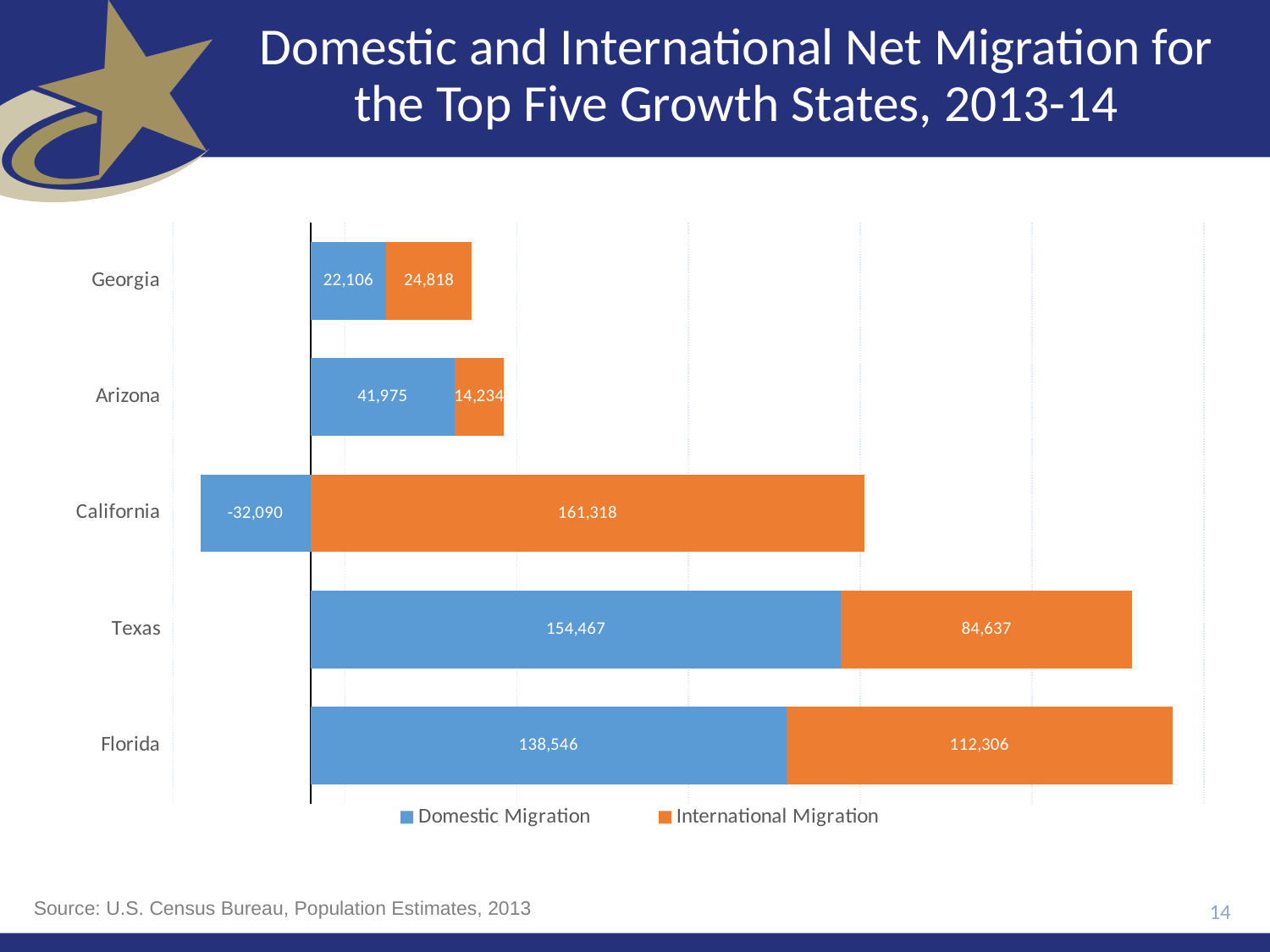
What is the Domestic Migration value for Texas? 154,467 Which state has the highest Domestic Migration value? Texas How many states are shown in the chart? 5 Which is larger for Georgia, Domestic Migration or International Migration? International Migration What is the International Migration value for California? 161,318 How many series does the legend list? 2 Which state has the lowest International Migration value? Arizona What kind of chart is shown on the slide? Stacked bar chart What is the Domestic Migration value for California? -32,090 What is the total of the stacked bar for Florida? 250,852 What is the difference between Florida's Domestic Migration and International Migration values? 26,240 What is the International Migration value for Arizona? 14,234